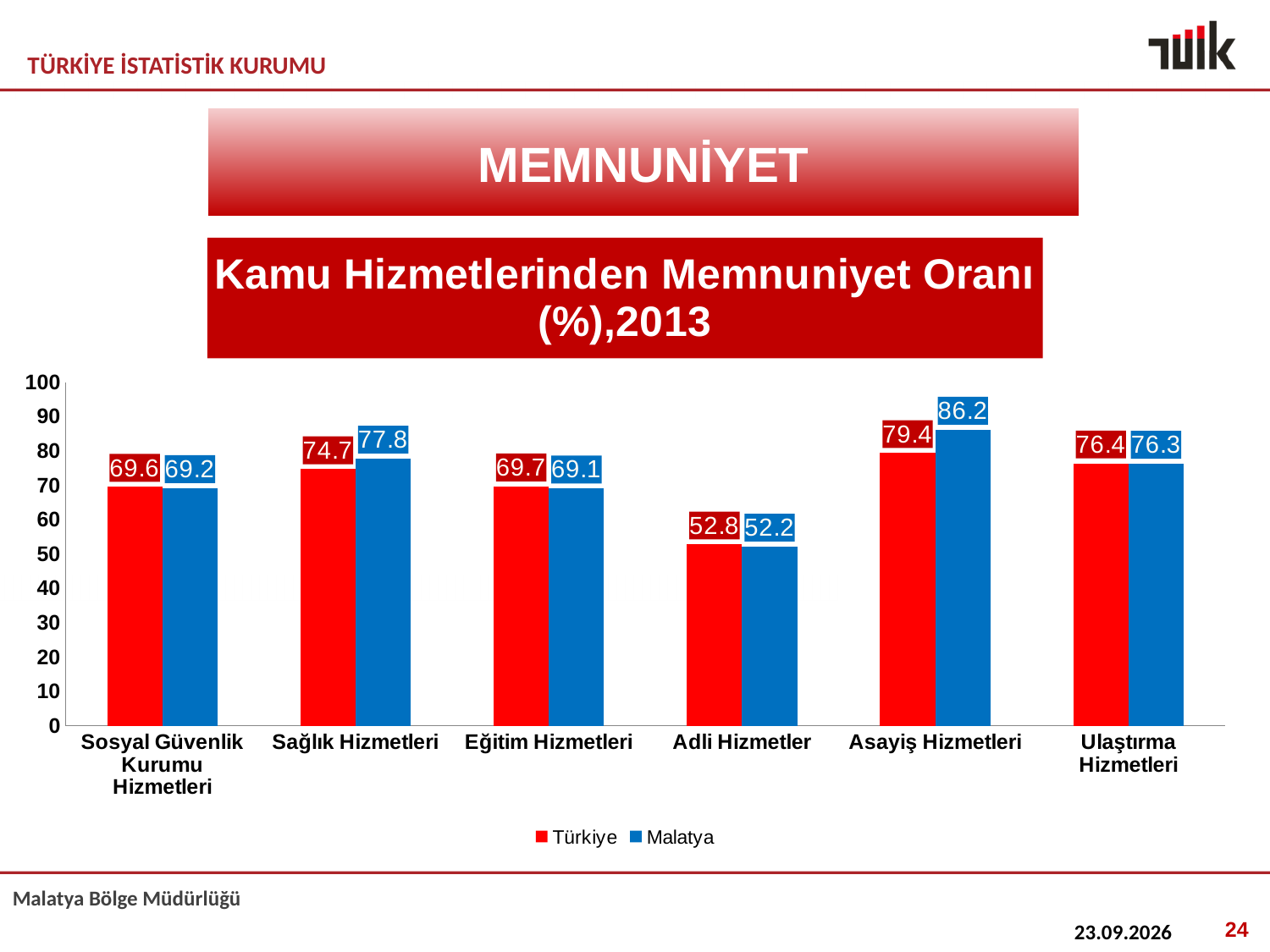
For Sağlık Hizmetleri, which is larger: the Türkiye value or the Malatya value? Malatya What is the Türkiye value for Sağlık Hizmetleri? 74.7 Which category has the lowest Türkiye value? Adli Hizmetler What is the Malatya value for Asayiş Hizmetleri? 86.2 What is the Türkiye value for Adli Hizmetler? 52.8 Is the Malatya value for Adli Hizmetler greater or less than 60? less What kind of chart is shown on the slide? bar chart How many categories are shown on the x axis? 6 What is the difference between the Malatya and Türkiye values for Asayiş Hizmetleri? 6.8 Which colour represents Malatya in the chart? blue Which category has the highest Malatya value? Asayiş Hizmetleri How many series does the legend list? 2